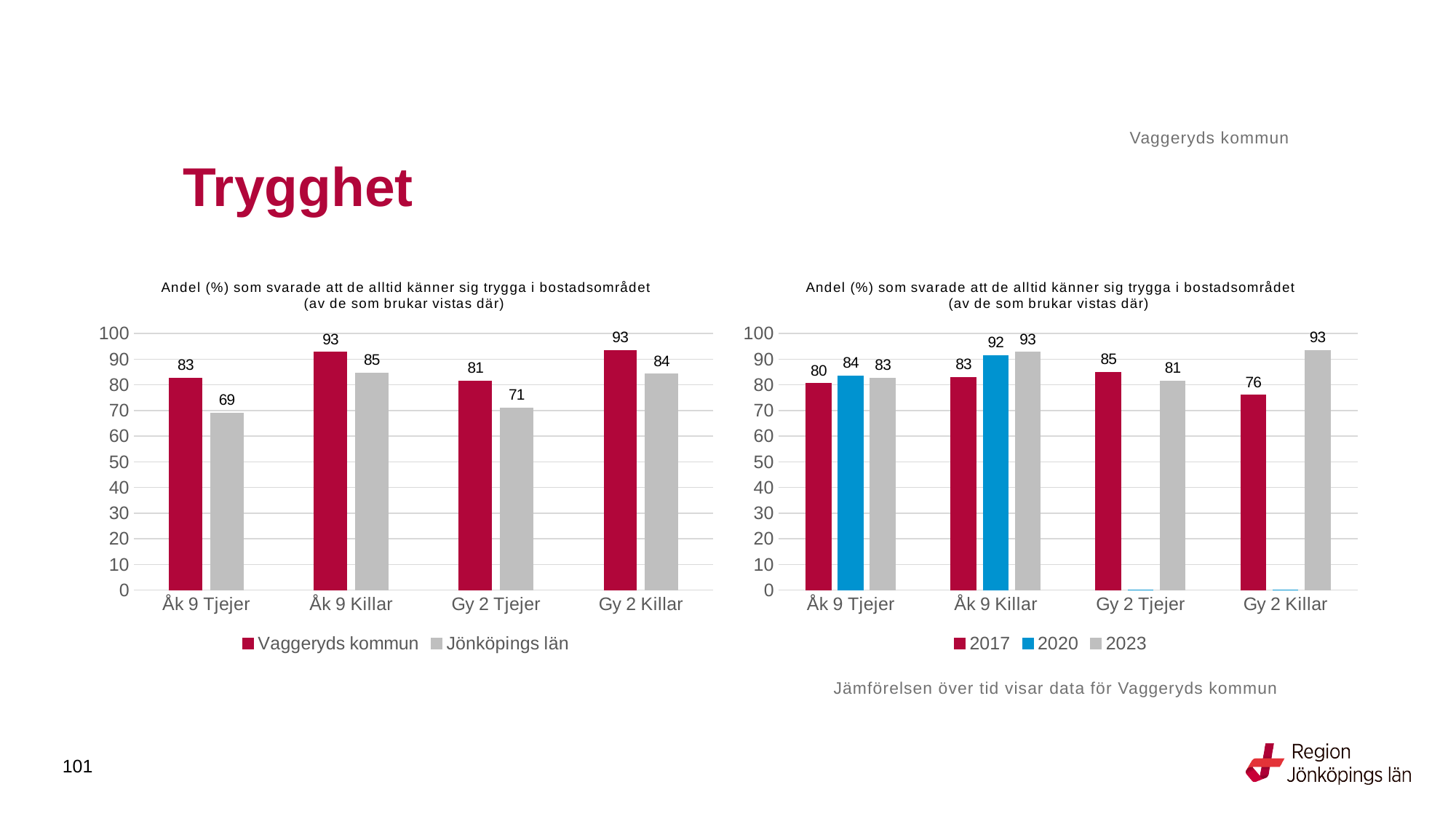
In the right chart, what is the difference between the 2023 and 2017 values for Gy 2 Killar? 17 In the left chart, which category has the lowest value for Jönköpings län? Åk 9 Tjejer In the right chart, what is the value for 2020 for Åk 9 Killar? 92 In the left chart, what is the value for Vaggeryds kommun for Åk 9 Tjejer? 83 In the left chart, what is the difference between Vaggeryds kommun and Jönköpings län for Åk 9 Tjejer? 14 In the left chart, how many series does the legend list? 2 What kind of chart is the left chart? Bar chart In the right chart, what is the value for 2017 for Gy 2 Killar? 76 In the left chart, what is the value for Jönköpings län for Gy 2 Tjejer? 71 In the right chart, how many series does the legend list? 3 How many categories are shown on the x axis of the right chart? 4 In the right chart, which is larger for Gy 2 Tjejer: the 2017 value or the 2023 value? 2017